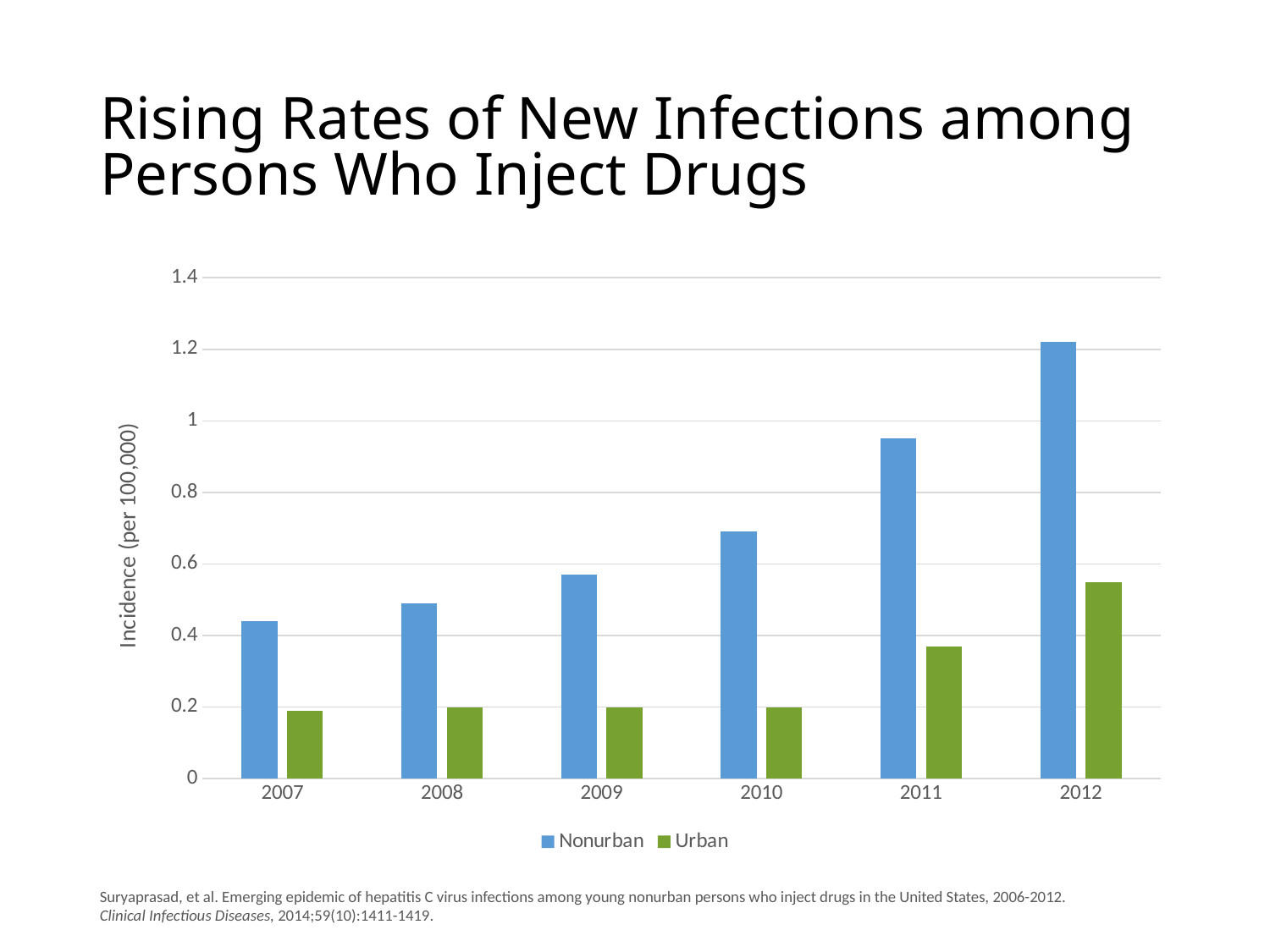
Is the Urban value for 2012 greater or less than 0.6? less In which year is the Nonurban incidence highest? 2012 Is the Urban value for 2011 greater or less than 0.4? less In which year is the Urban incidence highest? 2012 Do the Nonurban values rise or fall from 2007 to 2012? Rise How many years are shown on the x axis? 6 What kind of chart is shown on the slide? Bar chart How many series does the legend list? 2 Is the Nonurban value for 2012 greater or less than 1? greater In 2012, which series has the larger value, Nonurban or Urban? Nonurban In which year is the Nonurban incidence lowest? 2007